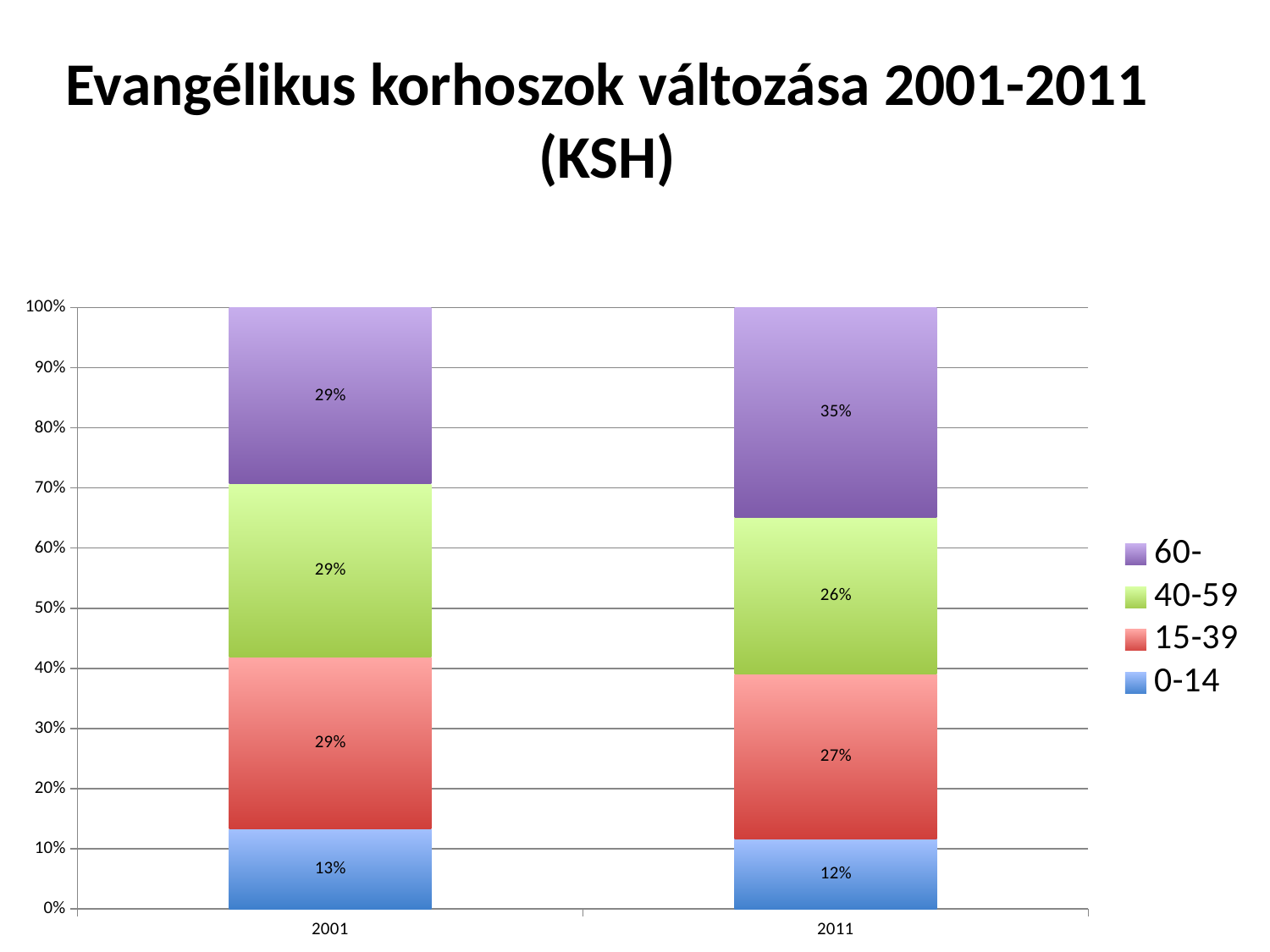
What kind of chart is shown on the slide? Stacked bar chart What is the value for the 40-59 series in 2011? 26% Which series has the lowest value in 2011? 0-14 Which is larger: the 15-39 value in 2001 or the 15-39 value in 2011? 2001 What is the value for the 15-39 series in 2001? 29% What is the title of the slide? Evangélikus korhoszok változása 2001-2011 (KSH) What is the value for the 60- series in 2011? 35% Which series has the highest value in 2011? 60- What is the value for the 0-14 series in 2001? 13% How many series does the legend list? 4 How many categories are shown on the x axis? 2 What is the difference between the 60- value in 2011 and the 60- value in 2001? 6%